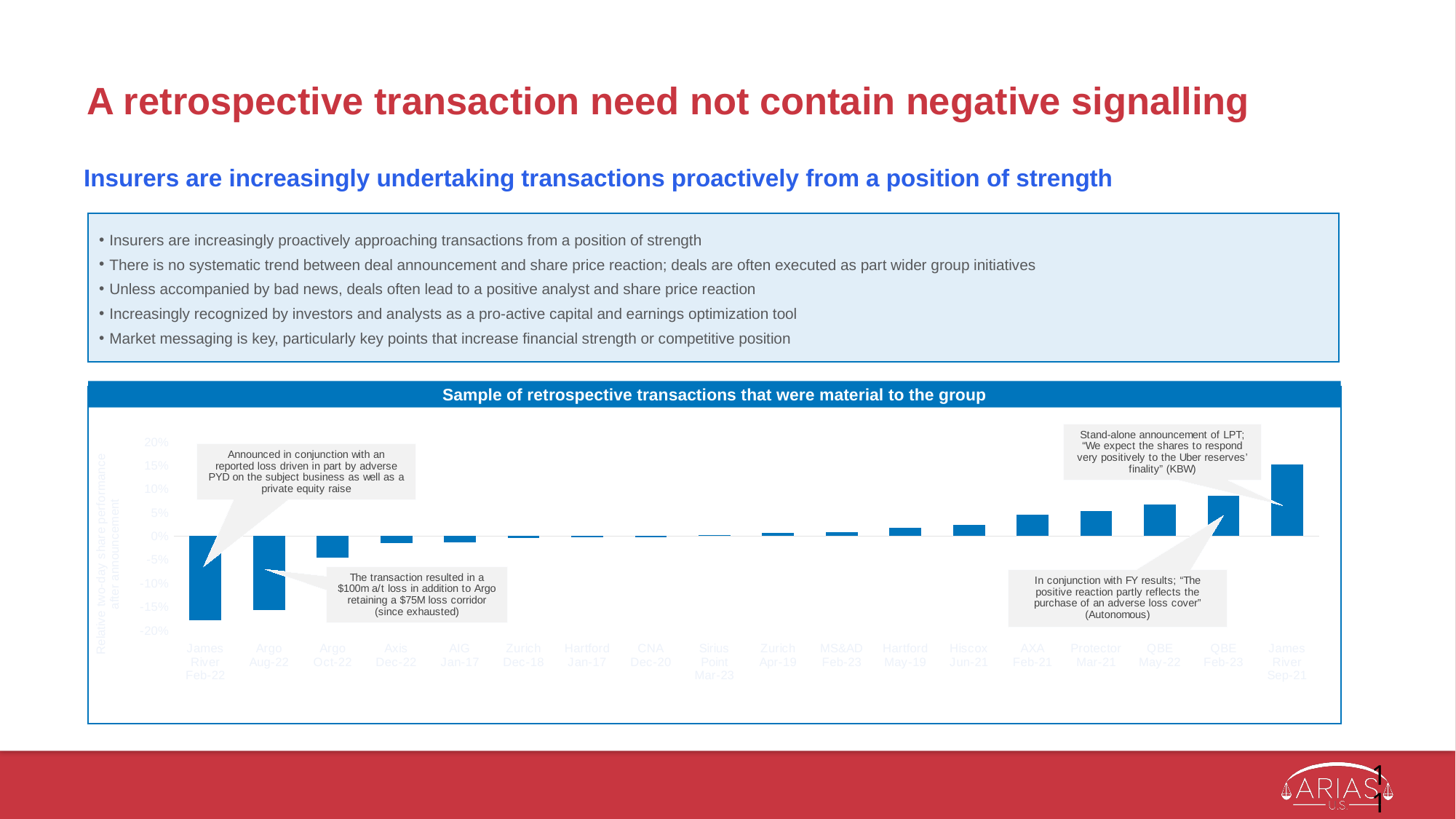
What type of chart is shown under the title 'Sample of retrospective transactions that were material to the group'? Bar chart Which has the higher share performance: QBE May-22 or QBE Feb-23? QBE Feb-23 Is the value for Argo Aug-22 greater or less than -10%? less Which transaction has the lowest relative two-day share performance in the chart? James River Feb-22 Is the value for Hiscox Jun-21 greater or less than 5%? less Is the value for James River Sep-21 greater or less than 10%? greater Which transaction has the highest relative two-day share performance in the chart? James River Sep-21 Do the bar values rise or fall moving from left to right along the x axis? Rise How many transactions (bars) are plotted in the chart? 18 What is the title of the chart on the slide? Sample of retrospective transactions that were material to the group